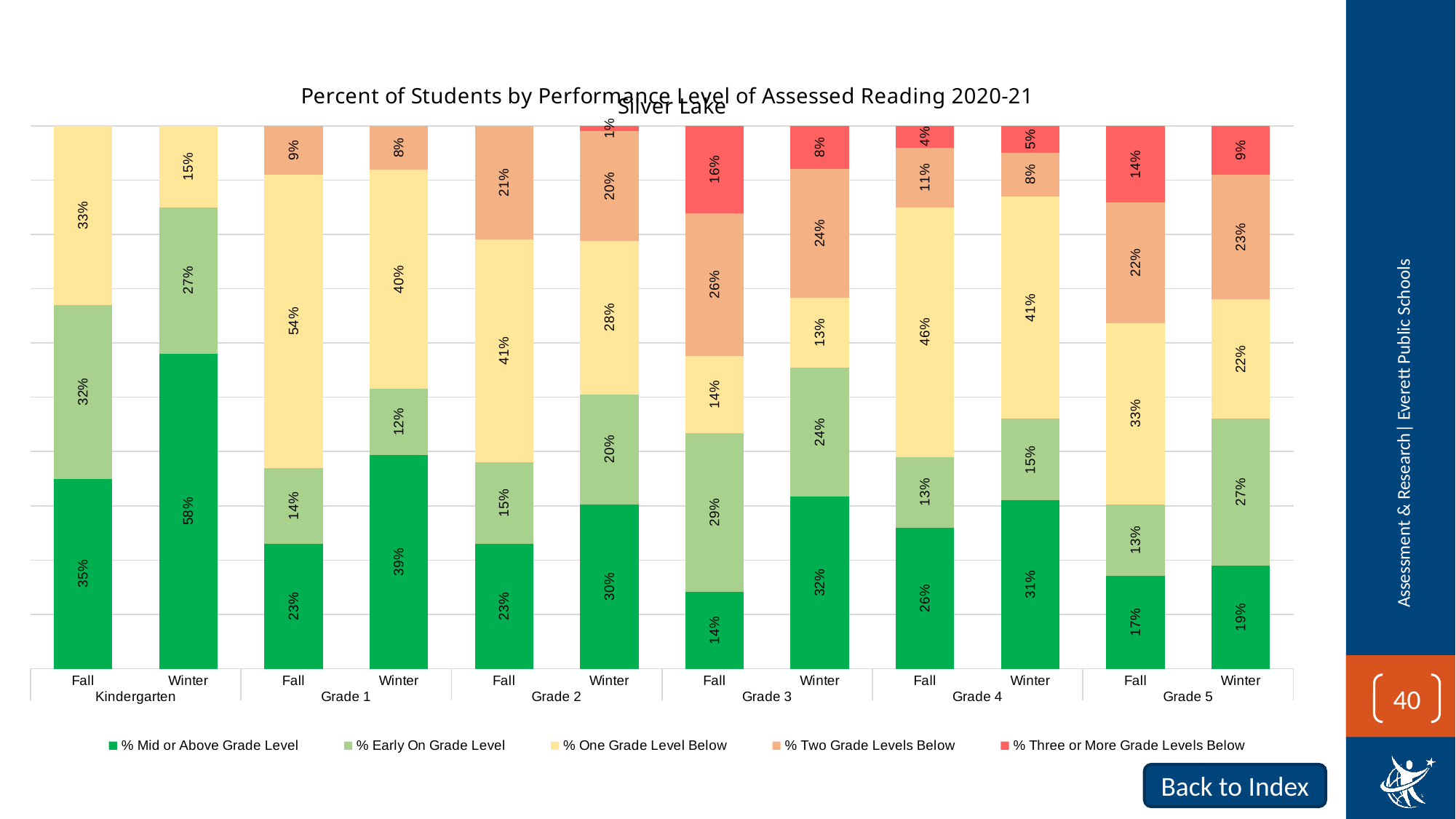
What is the % One Grade Level Below value for Grade 1 Fall? 54% Which bar has the lowest % Mid or Above Grade Level value? Grade 3 Fall What type of chart is shown on the slide? stacked bar chart What is the % Mid or Above Grade Level value for Kindergarten Winter? 58% How many bars are plotted in the chart? 12 Which bar has the highest % Mid or Above Grade Level value? Kindergarten Winter What is the % Three or More Grade Levels Below value for Grade 3 Fall? 16% Which is larger, the % Two Grade Levels Below value for Grade 5 Fall or for Grade 4 Fall? Grade 5 Fall What is the difference between the % Mid or Above Grade Level values for Grade 1 Winter and Grade 1 Fall? 16% What is the total of the Kindergarten Fall stacked bar? 100% How many series does the legend list? 5 What is the subtitle shown under the chart title? Silver Lake